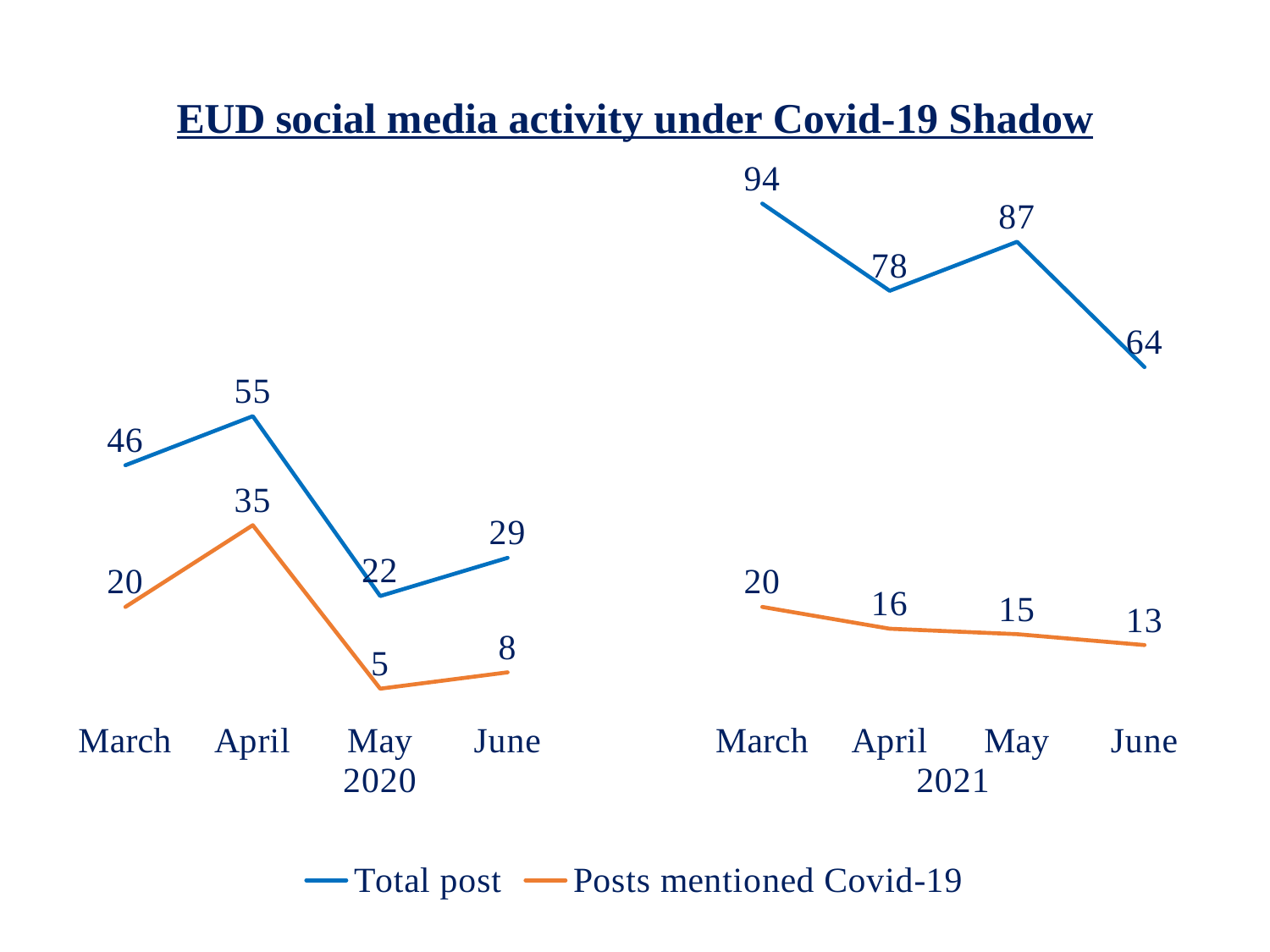
What is the value of Total post for April 2020? 55 What is the value of Posts mentioned Covid-19 for May 2020? 5 How many series does the legend list? 2 What is the value of Posts mentioned Covid-19 for June 2021? 13 In which month and year is Total post highest? March 2021 In which month and year is Posts mentioned Covid-19 lowest? May 2020 What is the value of Total post for March 2021? 94 What type of chart is shown on the slide? Line chart What is the difference between Total post and Posts mentioned Covid-19 in April 2020? 20 Which is larger: Total post in May 2021 or Total post in April 2021? Total post in May 2021 Does Posts mentioned Covid-19 rise or fall from March 2021 to June 2021? Fall What is the difference between Total post in March 2021 and Total post in June 2021? 30